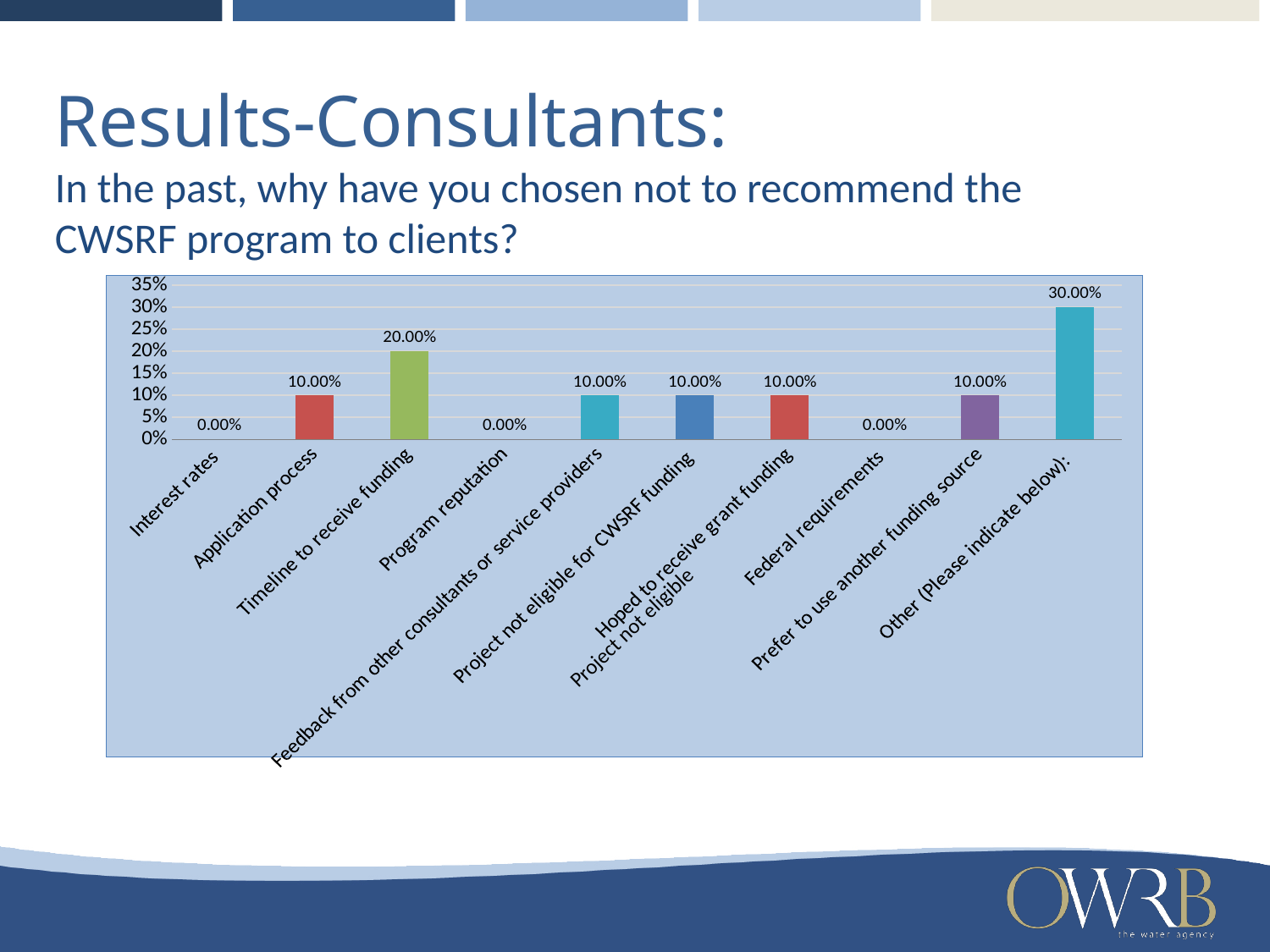
What is the value for Prefer to use another funding source? 10.00% What is the value for Interest rates? 0.00% What is the value for Federal requirements? 0.00% Is the value for Other (Please indicate below): greater or less than 25%? greater What is the value for Timeline to receive funding? 20.00% What is the difference between the values for Timeline to receive funding and Application process? 10.00% Which category has the highest value? Other (Please indicate below): What is the value for Other (Please indicate below):? 30.00% What kind of chart is shown on the slide? bar chart What is the difference between the values for Other (Please indicate below): and Timeline to receive funding? 10.00% Which is larger, the value for Timeline to receive funding or the value for Program reputation? Timeline to receive funding What is the value for Application process? 10.00%